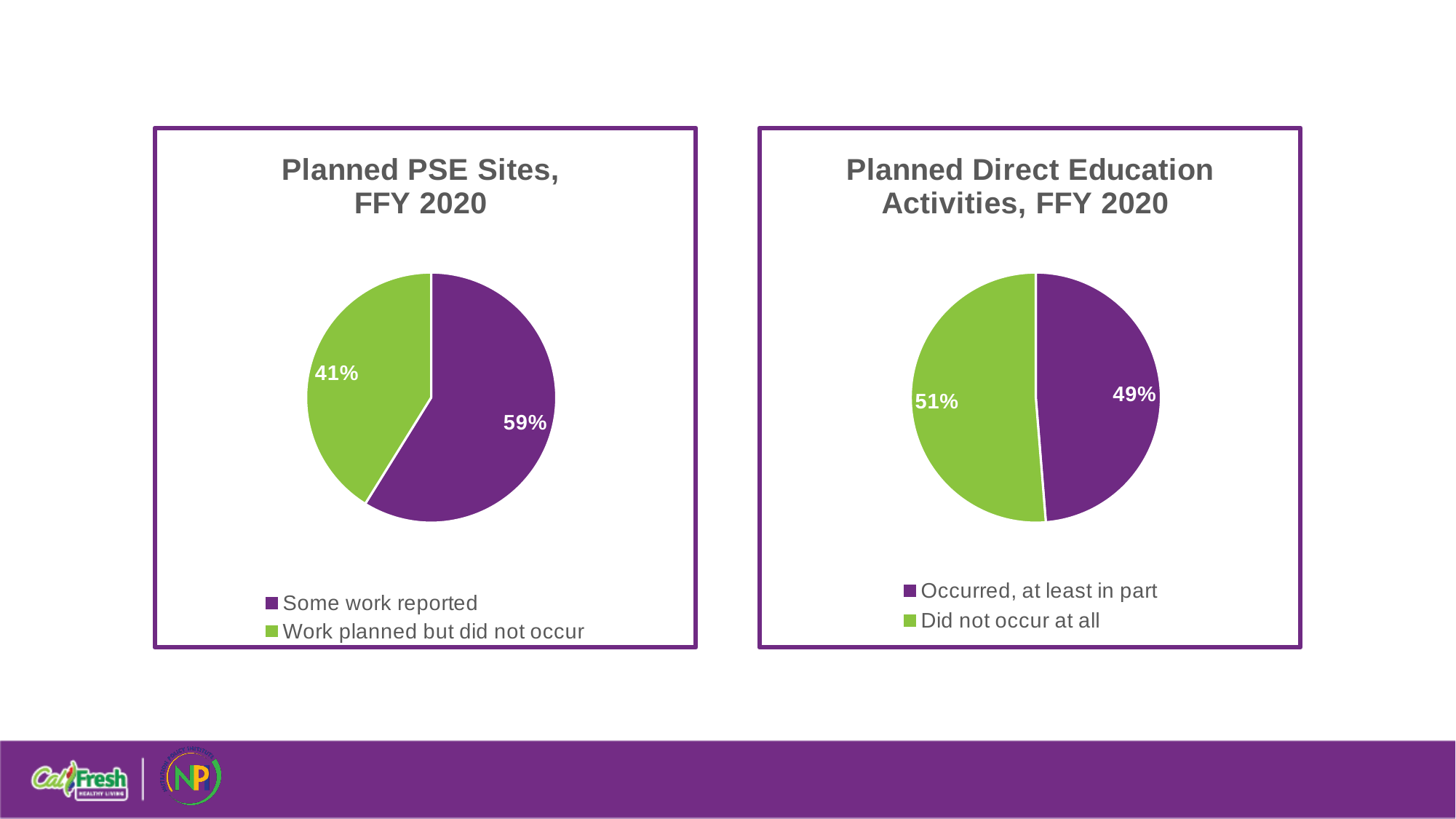
In the 'Planned PSE Sites, FFY 2020' chart, which slice is the largest? Some work reported How many slices does the 'Planned Direct Education Activities, FFY 2020' pie chart have? 2 In the 'Planned Direct Education Activities, FFY 2020' chart, what share of the pie is 'Did not occur at all'? 51% In the 'Planned Direct Education Activities, FFY 2020' chart, what share of the pie is 'Occurred, at least in part'? 49% In the 'Planned PSE Sites, FFY 2020' chart, what colour is the 'Work planned but did not occur' slice? Green What kind of chart is the 'Planned PSE Sites, FFY 2020' chart? Pie chart In the 'Planned PSE Sites, FFY 2020' chart, what share of the pie is 'Some work reported'? 59% In the 'Planned PSE Sites, FFY 2020' chart, what is the difference in percentage points between 'Some work reported' and 'Work planned but did not occur'? 18 percentage points In the 'Planned Direct Education Activities, FFY 2020' chart, what is the difference in percentage points between 'Did not occur at all' and 'Occurred, at least in part'? 2 percentage points In the 'Planned PSE Sites, FFY 2020' chart, what share of the pie is 'Work planned but did not occur'? 41% In the 'Planned Direct Education Activities, FFY 2020' chart, which slice is the smallest? Occurred, at least in part What is the title of the chart on the right side of the slide? Planned Direct Education Activities, FFY 2020